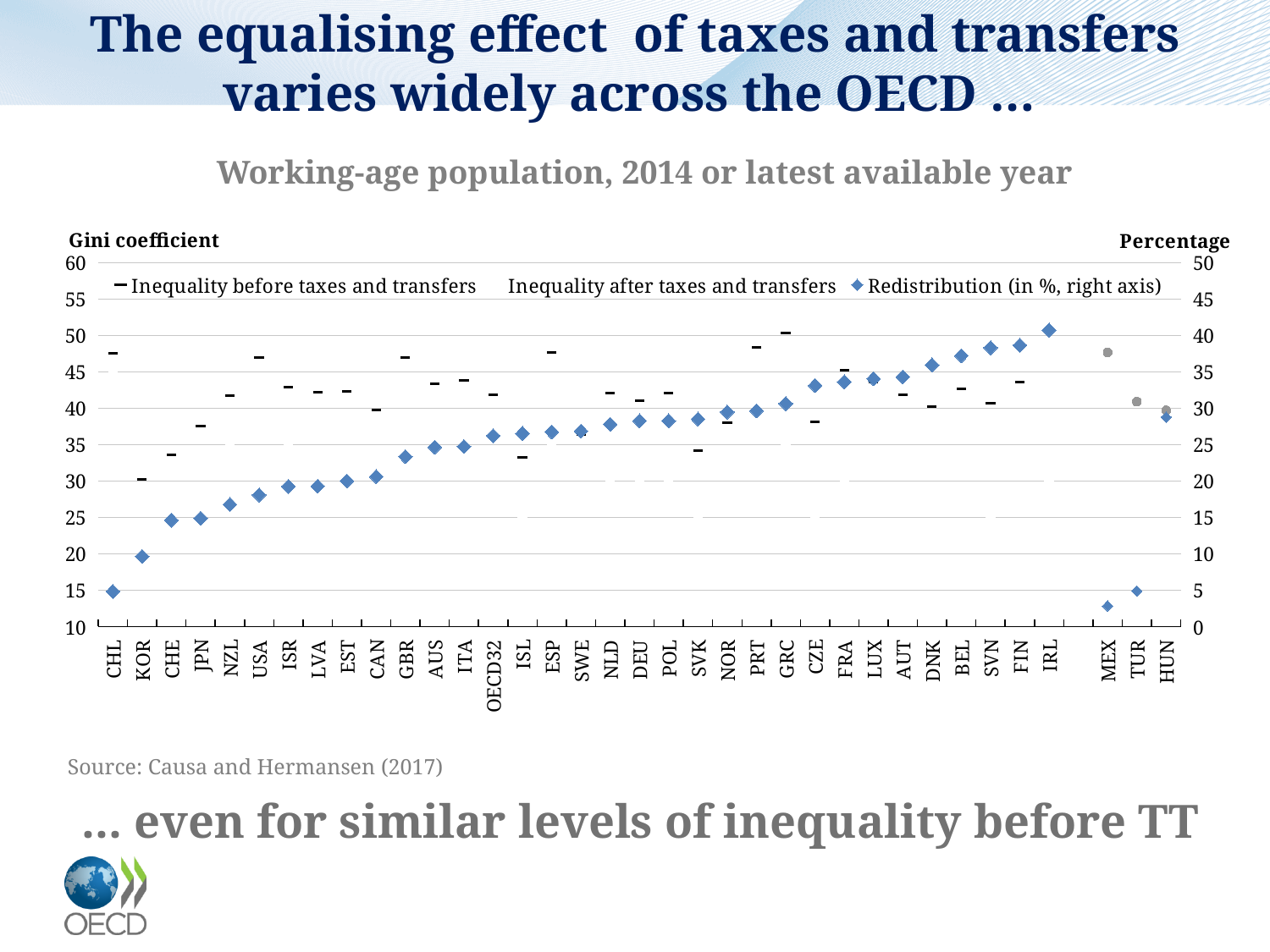
Do the Redistribution values rise or fall along the x axis from CHL to IRL? rise Is the Inequality before taxes and transfers value for KOR greater or less than 35? less Which has the larger Redistribution value, FIN or USA? FIN Is the Redistribution value for CHL greater or less than 10? less Which country has the highest Redistribution value in the chart? IRL Which country has the lowest Redistribution value in the chart? MEX How many series does the chart legend list? 3 How many countries/categories are shown on the x axis of the chart? 36 Is the Redistribution value for IRL greater or less than 35? greater Which series in the chart is plotted on the right axis? Redistribution (in %, right axis) What is the title of the left vertical axis of the chart? Gini coefficient